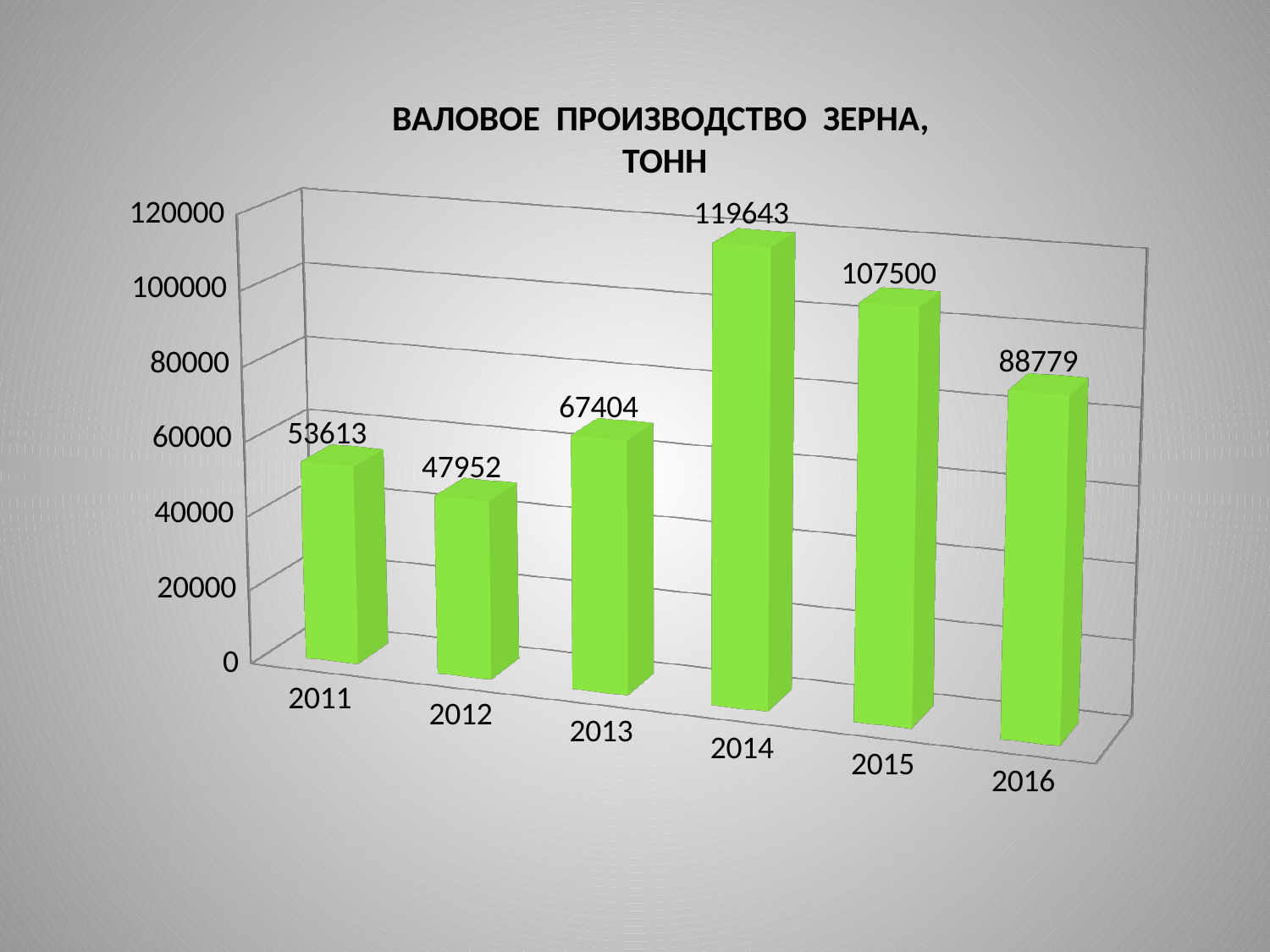
Is the value for 2013 greater or less than 60000? greater What is the value for 2014? 119643 Which year has the lowest value? 2012 What is the title of the chart? ВАЛОВОЕ ПРОИЗВОДСТВО ЗЕРНА, ТОНН What is the difference between the values for 2013 and 2011? 13791 How many years are shown on the chart? 6 What is the difference between the values for 2014 and 2015? 12143 Which is larger, the value for 2015 or the value for 2016? 2015 What is the value for 2016? 88779 What is the value for 2012? 47952 What kind of chart is this? bar chart Which year has the highest value? 2014